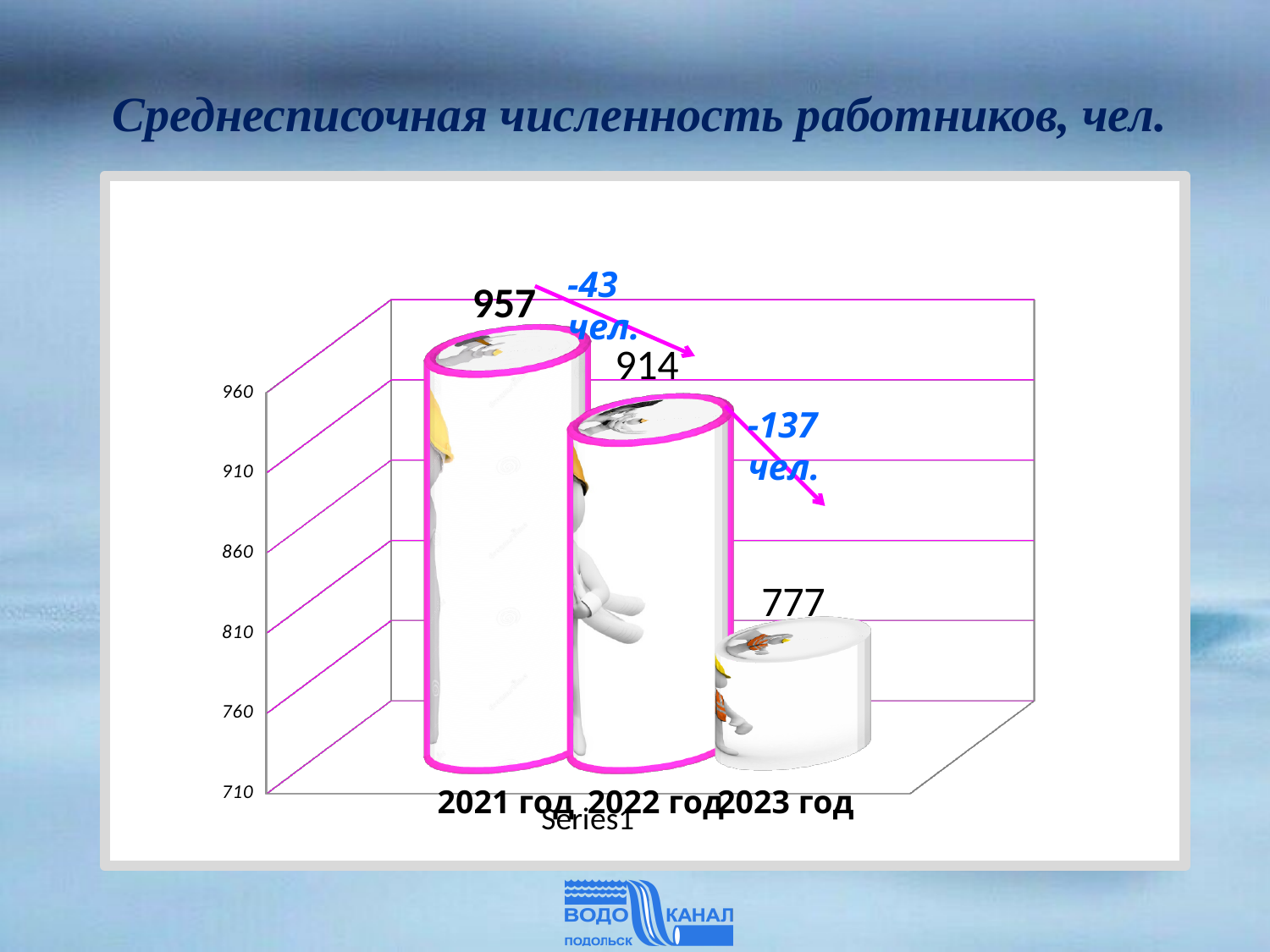
What is the difference between the values for 2021 год and 2022 год? 43 What is the value for 2021 год? 957 What is the difference between the values for 2022 год and 2023 год? 137 What is the value for 2023 год? 777 What is the value for 2022 год? 914 Which year has the lowest value? 2023 год Do the values rise or fall from 2021 год to 2023 год? fall What kind of chart is shown on the slide? bar chart Which is larger, the value for 2022 год or the value for 2023 год? 2022 год Which year has the highest value? 2021 год Is the value for 2023 год greater or less than 810? less How many categories are shown on the x axis? 3